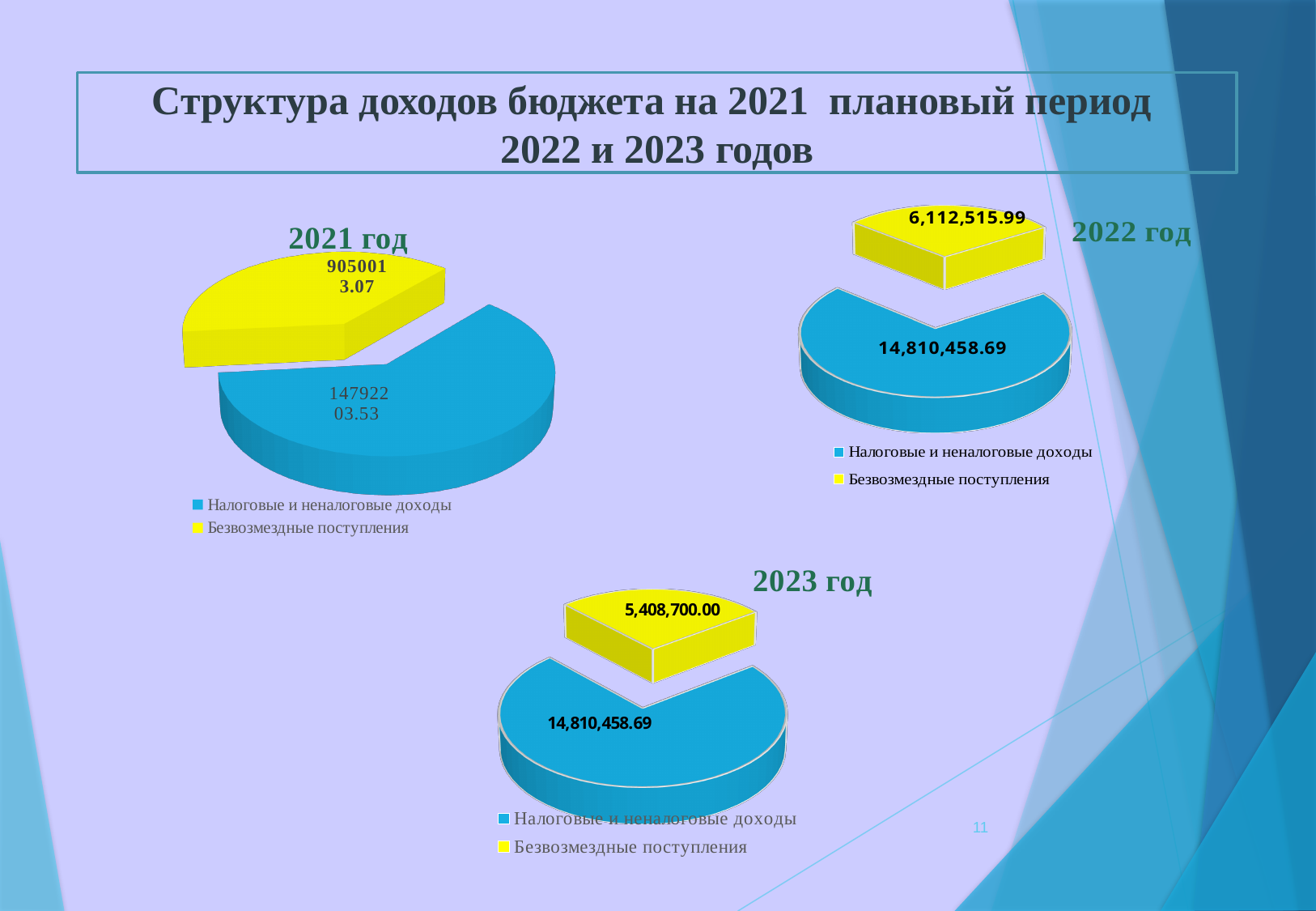
Is the value for Безвозмездные поступления larger on the 2022 год chart or the 2023 год chart? 2022 год On the 2022 год chart, what is the difference between Налоговые и неналоговые доходы and Безвозмездные поступления? 8,697,942.70 On the 2022 год chart, what is the value for Безвозмездные поступления? 6,112,515.99 On the 2021 год chart, which category has the larger slice? Налоговые и неналоговые доходы On the 2023 год chart, what is the difference between Налоговые и неналоговые доходы and Безвозмездные поступления? 9,401,758.69 On the 2022 год chart, what is the total of the two slices? 20,922,974.68 On the 2023 год chart, what is the value for Налоговые и неналоговые доходы? 14,810,458.69 On the 2022 год chart, what is the value for Налоговые и неналоговые доходы? 14,810,458.69 On the 2023 год chart, which category has the smallest slice? Безвозмездные поступления How many categories does the legend of the 2023 год chart list? 2 On the 2023 год chart, what is the value for Безвозмездные поступления? 5,408,700.00 What kind of chart is used for the 2021 год data? Pie chart